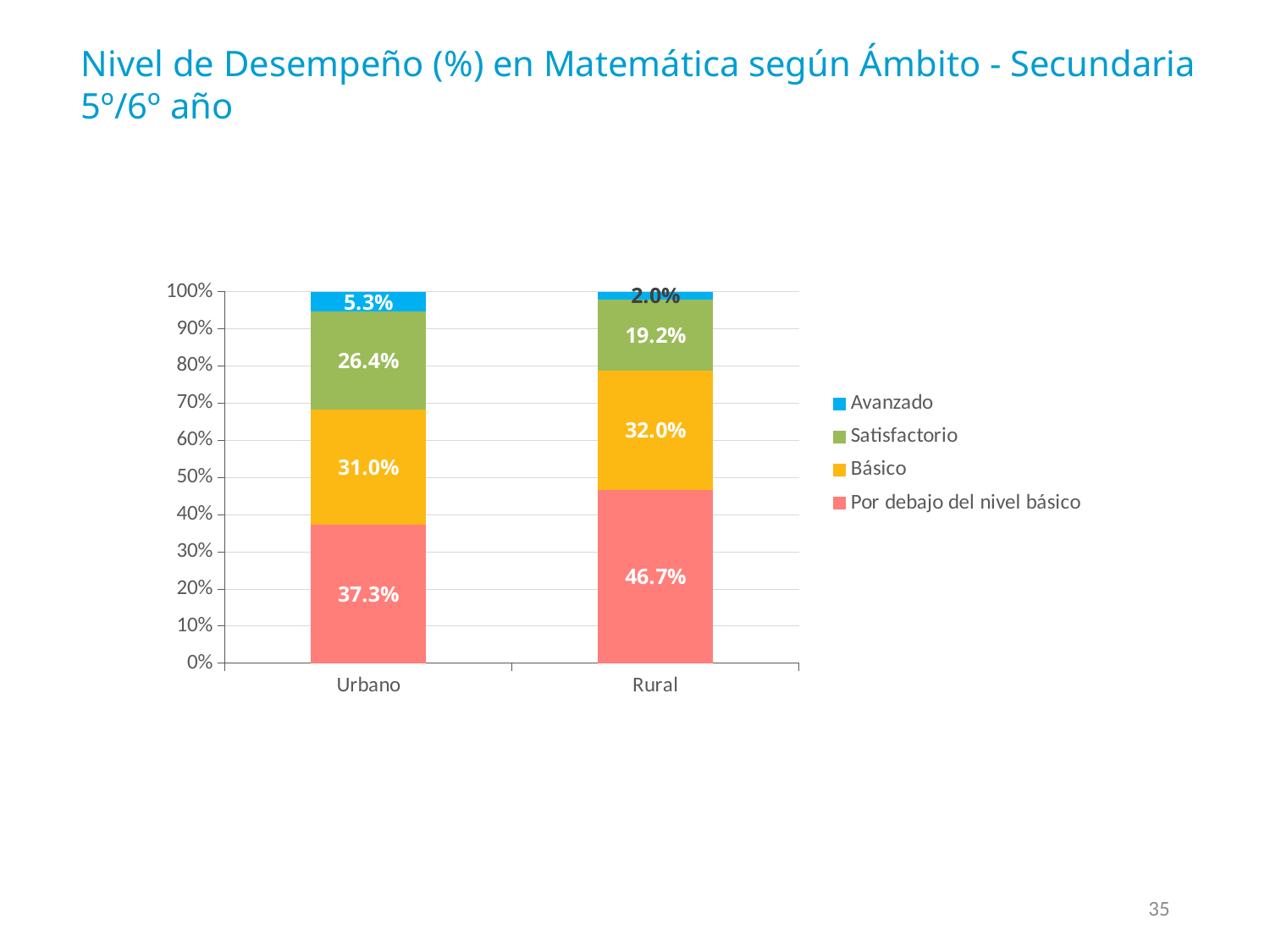
What is the value for Satisfactorio in the Rural bar? 19.2% Which category has the higher value for Avanzado, Urbano or Rural? Urbano Which legend entry is shown in yellow? Básico How many series does the legend list? 4 What is the difference between the Por debajo del nivel básico values for Rural and Urbano? 9.4% What is the value for Avanzado in the Urbano bar? 5.3% Which category has the higher value for Por debajo del nivel básico, Urbano or Rural? Rural How many categories are shown on the x axis? 2 What kind of chart is shown on the slide? Stacked bar chart What is the value for Básico in the Urbano bar? 31.0% What is the value for Por debajo del nivel básico in the Rural bar? 46.7% What is the difference between the Satisfactorio values for Urbano and Rural? 7.2%